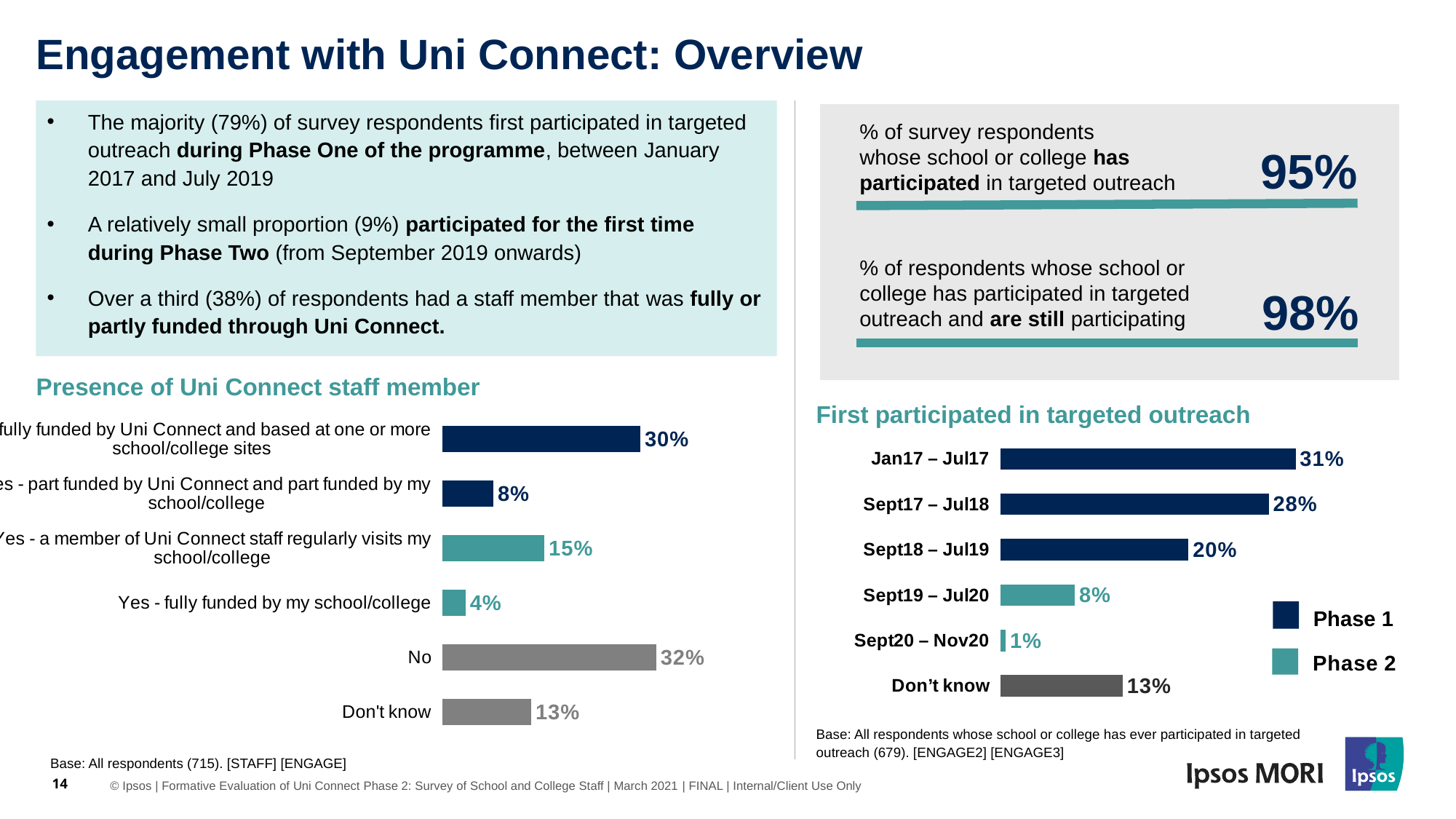
In the 'First participated in targeted outreach' chart, do the values rise or fall from Jan17 – Jul17 through Sept20 – Nov20? fall In the 'First participated in targeted outreach' chart, which period has the lowest value? Sept20 – Nov20 In the 'Presence of Uni Connect staff member' chart, what is the value for 'Yes - fully funded by my school/college'? 4% In the 'Presence of Uni Connect staff member' chart, what is the value for 'No'? 32% In the 'Presence of Uni Connect staff member' chart, which category has the highest value? No In the 'First participated in targeted outreach' chart, what is the value for Jan17 – Jul17? 31% In the 'Presence of Uni Connect staff member' chart, which is larger: 'Don't know' or 'Yes - fully funded by my school/college'? Don't know In the 'First participated in targeted outreach' chart, what is the difference between Sept17 – Jul18 and Sept18 – Jul19? 8% In the 'First participated in targeted outreach' chart, how many entries does the legend list? 2 In the 'First participated in targeted outreach' chart, what is the value for Sept19 – Jul20? 8% What kind of chart is the 'Presence of Uni Connect staff member' chart? bar chart In the 'First participated in targeted outreach' chart, how many categories are shown? 6